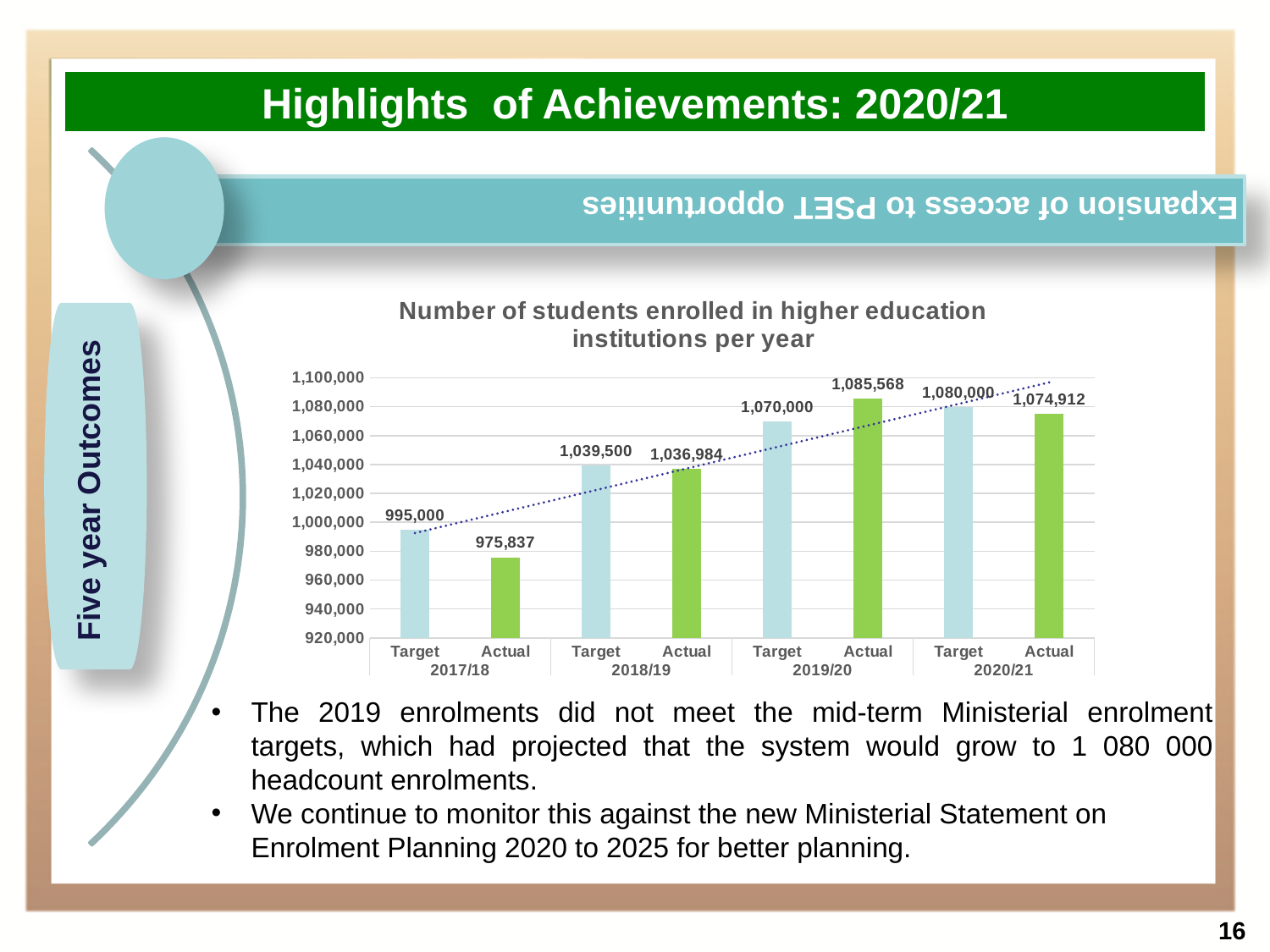
What is the Target value for 2018/19? 1,039,500 What is the difference between the Target and Actual values for 2020/21? 5,088 What kind of chart is shown on the slide? Bar chart How many bars are plotted in the chart? 8 Which bar has the highest value? Actual 2019/20 What is the Actual value for 2020/21? 1,074,912 What is the title of the chart? Number of students enrolled in higher education institutions per year What is the Target value for 2017/18? 995,000 What is the difference between the Target and Actual values for 2017/18? 19,163 Which is larger, the Actual value for 2019/20 or the Target value for 2019/20? Actual 2019/20 What is the Actual value for 2019/20? 1,085,568 Which bar has the lowest value? Actual 2017/18